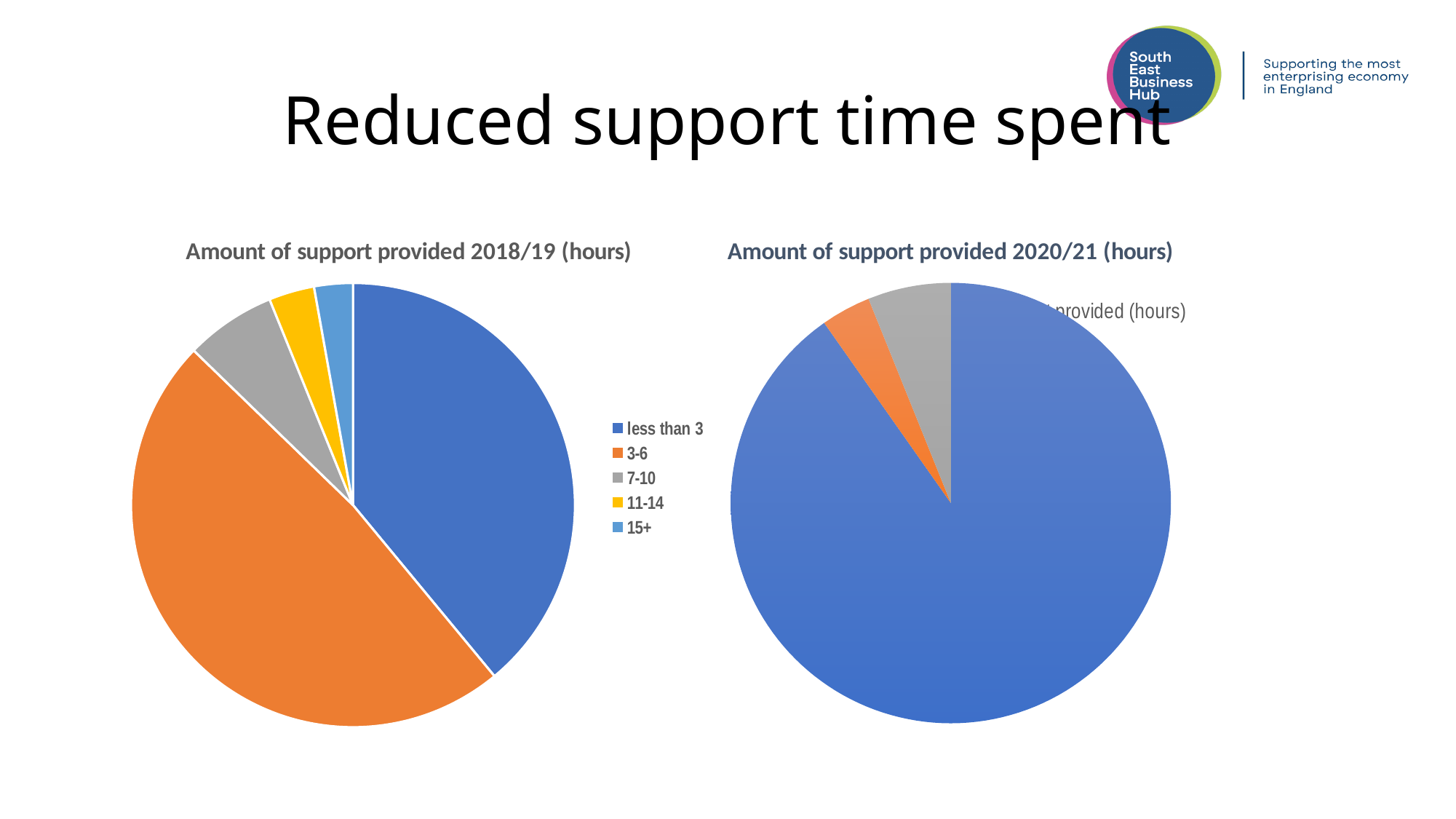
How many categories does the legend of the 'Amount of support provided 2018/19 (hours)' chart list? 5 What is the title of the pie chart on the left of the slide? Amount of support provided 2018/19 (hours) How many slices does the 'Amount of support provided 2020/21 (hours)' pie chart have? 3 In the 'Amount of support provided 2020/21 (hours)' chart, which colour is the largest slice? blue In the 'Amount of support provided 2018/19 (hours)' chart, which category has the largest slice? 3-6 What kind of chart is the 'Amount of support provided 2018/19 (hours)' chart? pie chart In the 'Amount of support provided 2018/19 (hours)' chart, which slice is larger: '3-6' or 'less than 3'? 3-6 How many slices does the 'Amount of support provided 2018/19 (hours)' pie chart have? 5 What kind of chart is the 'Amount of support provided 2020/21 (hours)' chart? pie chart In the 'Amount of support provided 2018/19 (hours)' chart, which slice is larger: '7-10' or '11-14'? 7-10 In the 'Amount of support provided 2018/19 (hours)' chart, which slice is larger: 'less than 3' or '7-10'? less than 3 In the 'Amount of support provided 2018/19 (hours)' chart, what colour is the '11-14' slice? yellow